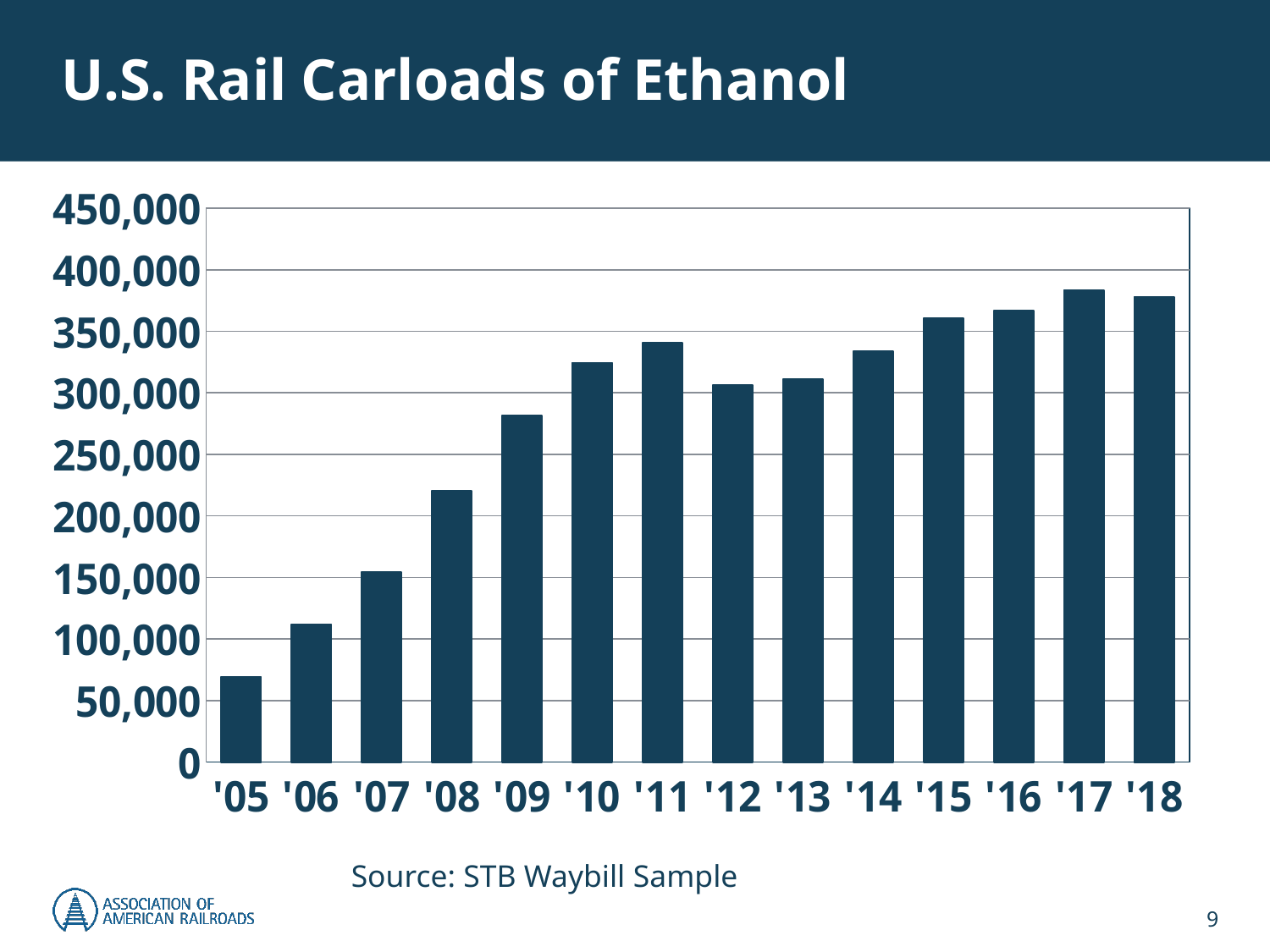
Is the value for '18 greater or less than 400,000? less Is the value for '05 greater or less than 100,000? less Is the value for '15 greater or less than 350,000? greater Which is larger, the value for '11 or the value for '12? '11 Which is larger, the value for '07 or the value for '10? '10 Which year has the lowest number of rail carloads of ethanol? '05 What is the title of the chart? U.S. Rail Carloads of Ethanol Do the values generally rise or fall from '05 to '18? rise What kind of chart is shown on the slide? bar chart How many years are shown on the x axis of the chart? 14